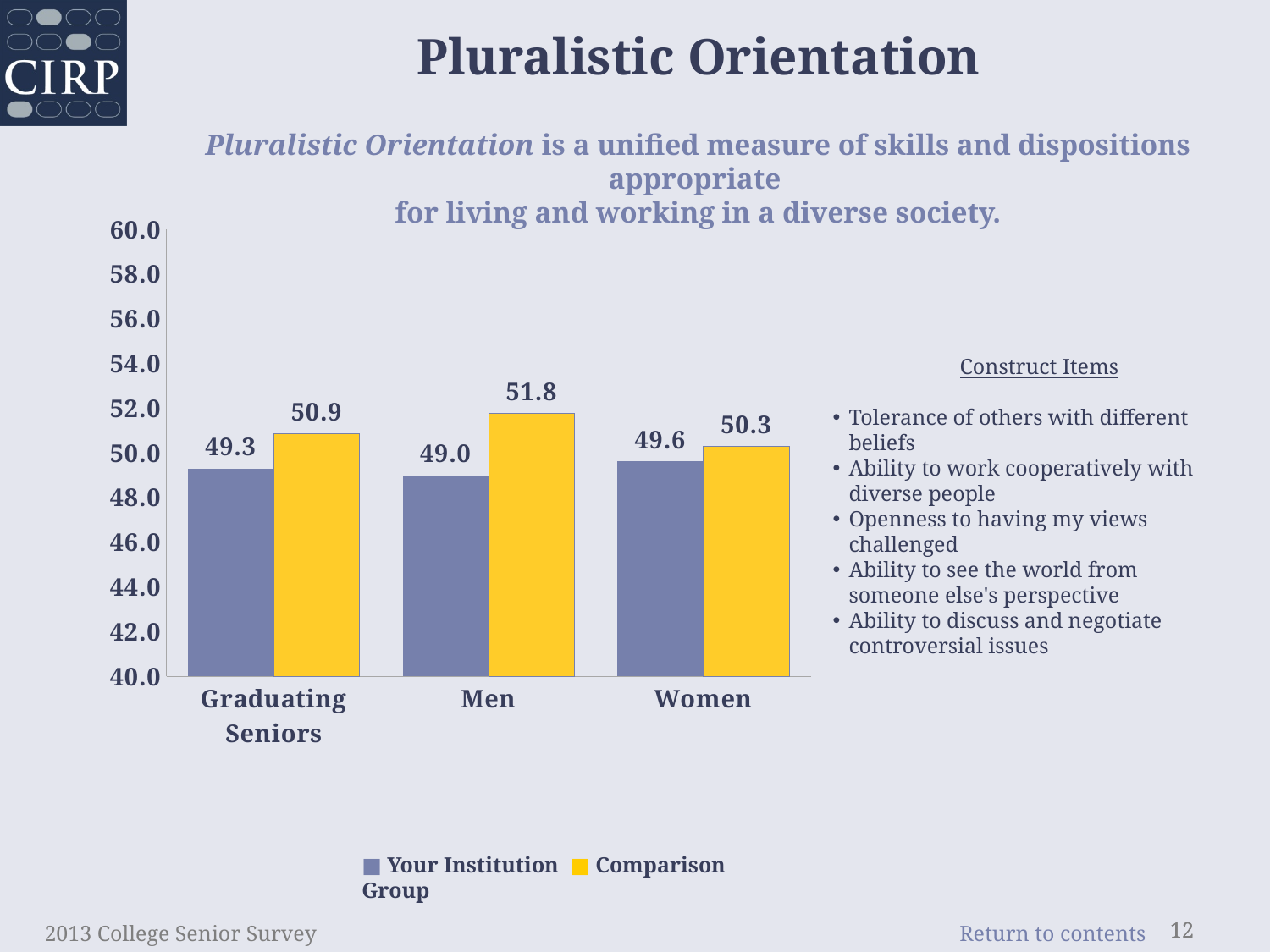
How many categories are shown on the x axis? 3 Which category has the lowest Your Institution value? Men How many series does the legend list? 2 What is the Comparison Group value for Women? 50.3 For Graduating Seniors, which is larger: Your Institution or Comparison Group? Comparison Group What is the difference between the Comparison Group and Your Institution values for Men? 2.8 What is the Your Institution value for Women? 49.6 What is the Comparison Group value for Men? 51.8 Is the Comparison Group value for Graduating Seniors greater or less than 50.0? greater What kind of chart is shown on the slide? bar chart What is the Your Institution value for Graduating Seniors? 49.3 Which category has the highest Comparison Group value? Men